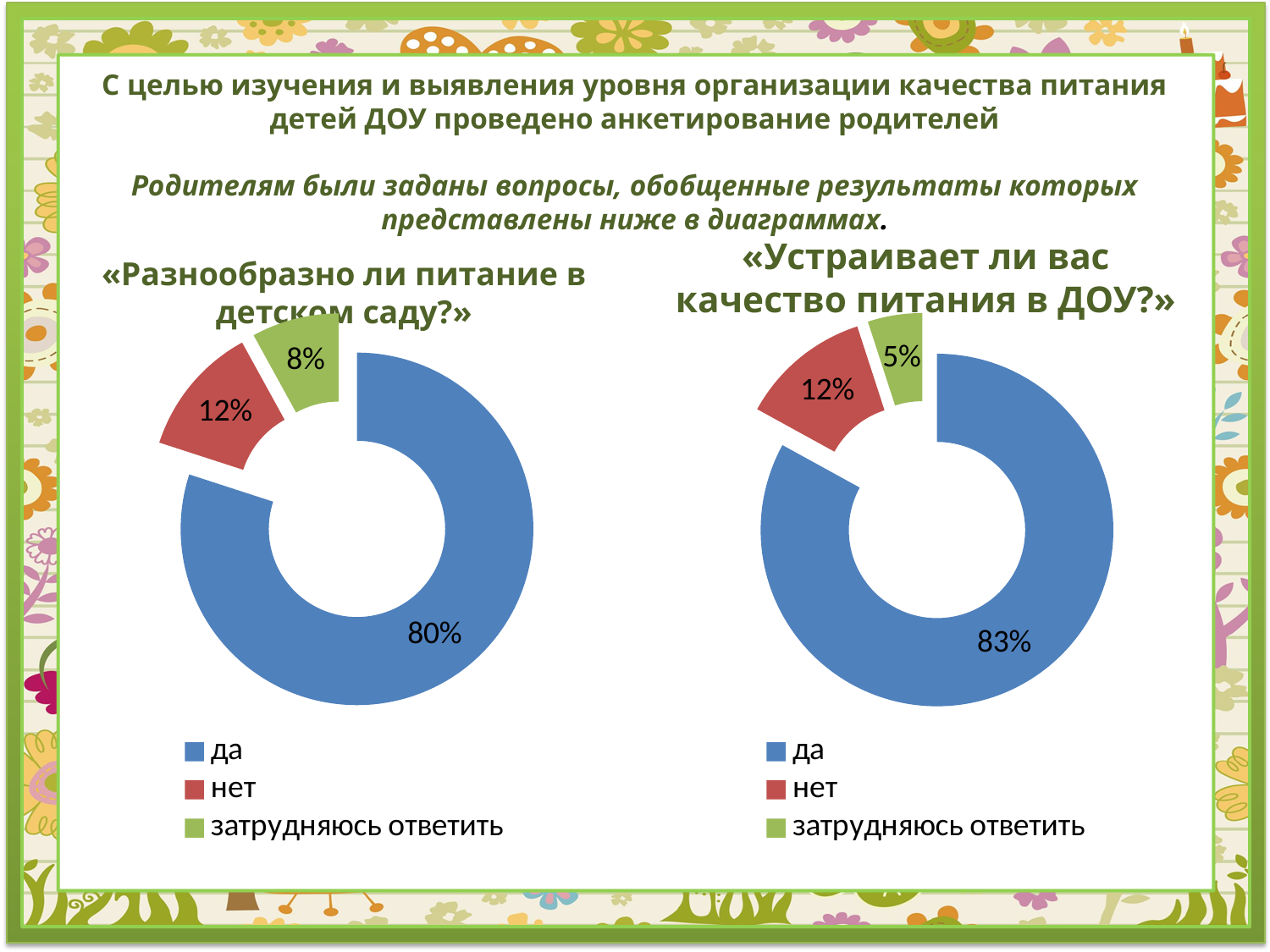
In the left chart «Разнообразно ли питание в детском саду?», what percentage answered «да»? 80% In the right chart «Устраивает ли вас качество питания в ДОУ?», what percentage answered «затрудняюсь ответить»? 5% Which chart has the larger share for «да»: the left chart or the right chart? the right chart In the right chart «Устраивает ли вас качество питания в ДОУ?», which answer has the smallest share? затрудняюсь ответить How many categories does the legend of the right chart «Устраивает ли вас качество питания в ДОУ?» list? 3 In the left chart «Разнообразно ли питание в детском саду?», what percentage answered «затрудняюсь ответить»? 8% What type of chart is the left chart «Разнообразно ли питание в детском саду?»? doughnut (pie) chart In the left chart «Разнообразно ли питание в детском саду?», what is the difference between the «да» and «нет» shares? 68% In the right chart «Устраивает ли вас качество питания в ДОУ?», what percentage answered «да»? 83% In the left chart «Разнообразно ли питание в детском саду?», what percentage answered «нет»? 12% In the right chart «Устраивает ли вас качество питания в ДОУ?», what colour represents «нет»? red In the left chart «Разнообразно ли питание в детском саду?», which answer has the largest share? да